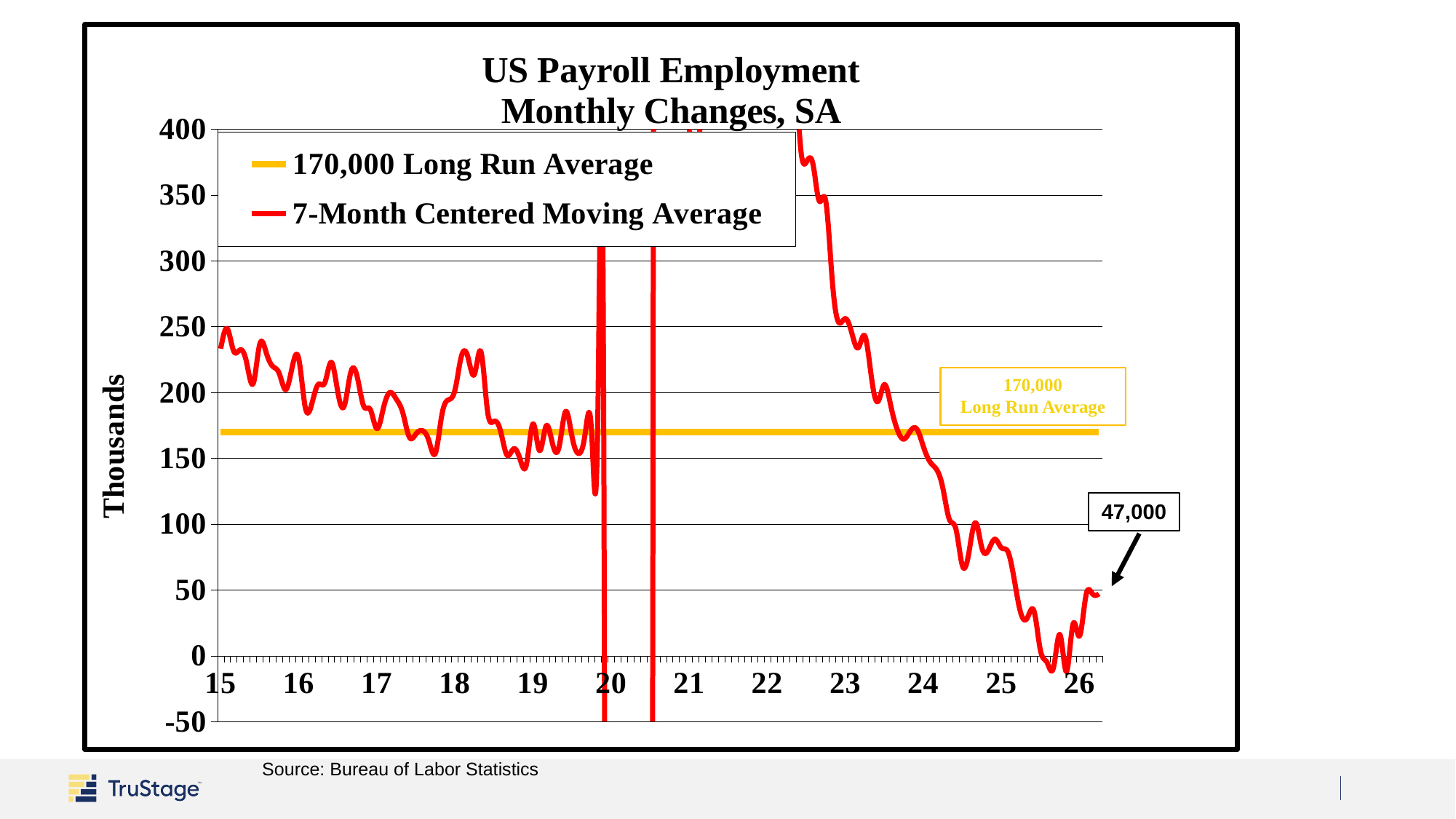
What is the value of the Long Run Average line? 170,000 How many series does the legend list? 2 What is the title of the chart? US Payroll Employment Monthly Changes, SA Does the 7-Month Centered Moving Average rise or fall between 23 and 26? fall Is the 7-Month Centered Moving Average at 26 greater or less than 50? less What value does the annotation at the right end of the 7-Month Centered Moving Average line show? 47,000 Is the 7-Month Centered Moving Average at the start of 15 greater or less than 200? greater How many year labels are shown on the x axis? 12 Is the 7-Month Centered Moving Average at 25 greater or less than 100? less What kind of chart is shown on the slide? line chart What is the label on the vertical axis? Thousands Which is larger, the 7-Month Centered Moving Average at 15 or at 25? 15